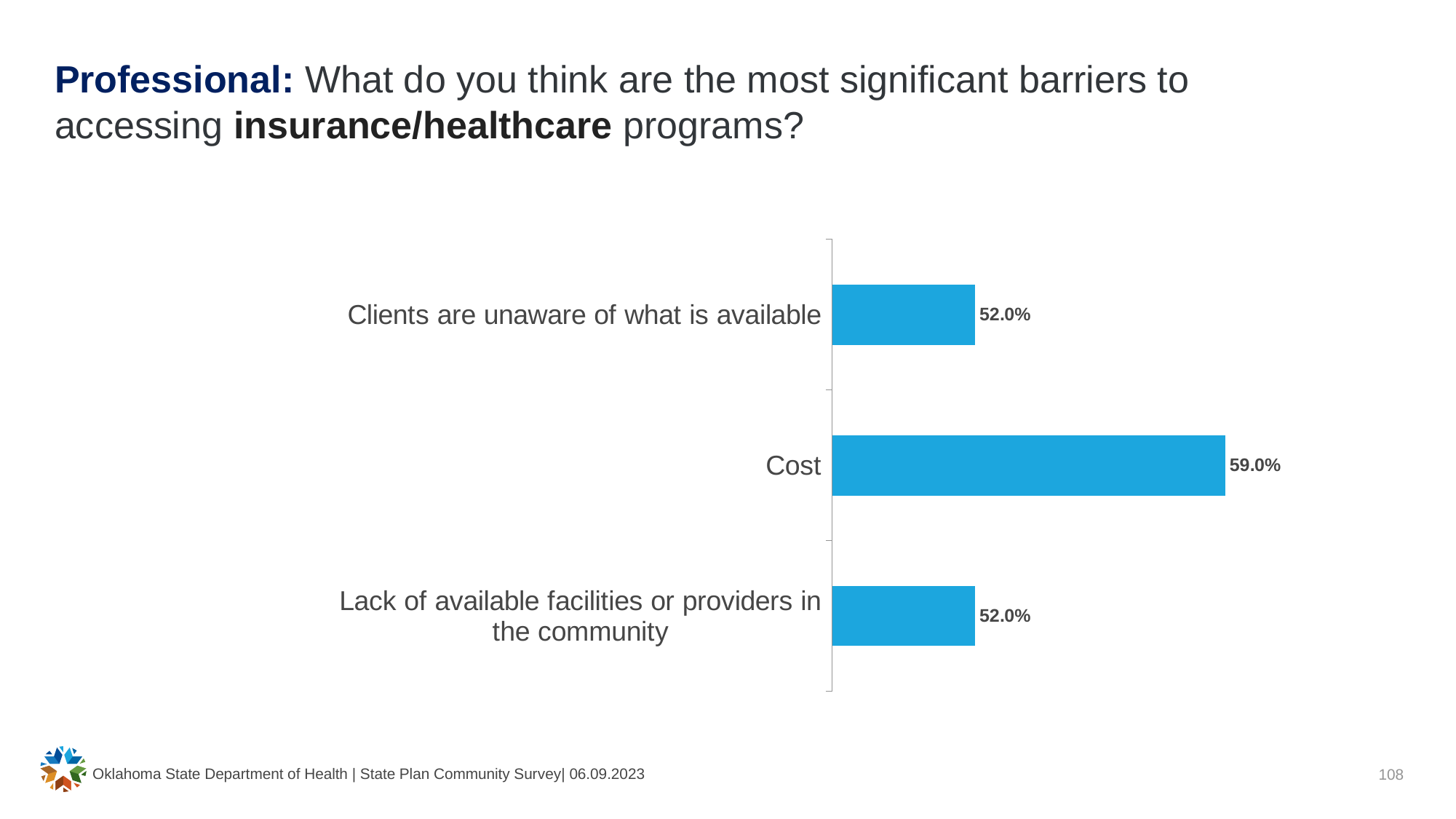
What kind of chart is shown on the slide? Bar chart Are the bars in the chart horizontal or vertical? Horizontal What is the value for Cost? 59.0% What colour are the bars in the chart? Blue Which is larger, the value for Cost or the value for Lack of available facilities or providers in the community? Cost Do the values for Clients are unaware of what is available and Lack of available facilities or providers in the community differ? No, both are 52.0% Which category has the highest value? Cost What is the value for Clients are unaware of what is available? 52.0% What is the value for Lack of available facilities or providers in the community? 52.0% What is the difference between the values for Cost and Clients are unaware of what is available? 7.0% How many categories are shown in the chart? 3